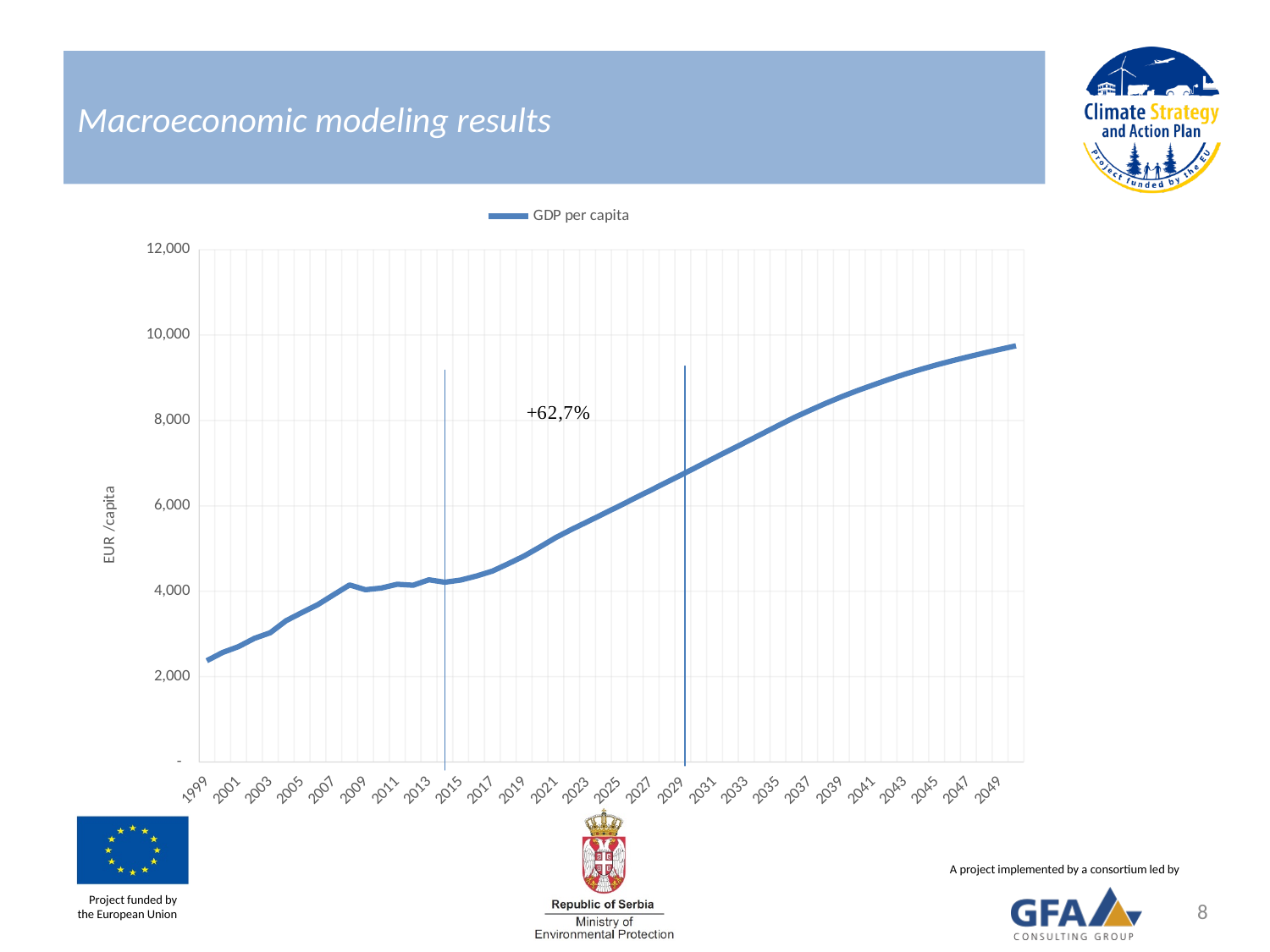
Does GDP per capita generally rise or fall from 1999 to 2049? rise How many series does the chart legend list? 1 Which year has the highest GDP per capita in the chart? 2050 Is the GDP per capita value for 2039 greater or less than 8,000? greater What percentage change is annotated on the chart between the two vertical marker lines? +62,7% Is the GDP per capita value for 1999 greater or less than 4,000? less What kind of chart is shown on the slide? line chart What is the label on the vertical axis of the chart? EUR /capita What is the name of the series shown in the chart legend? GDP per capita Which year has the lowest GDP per capita in the chart? 1999 Is the GDP per capita value for 2029 greater or less than 6,000? greater